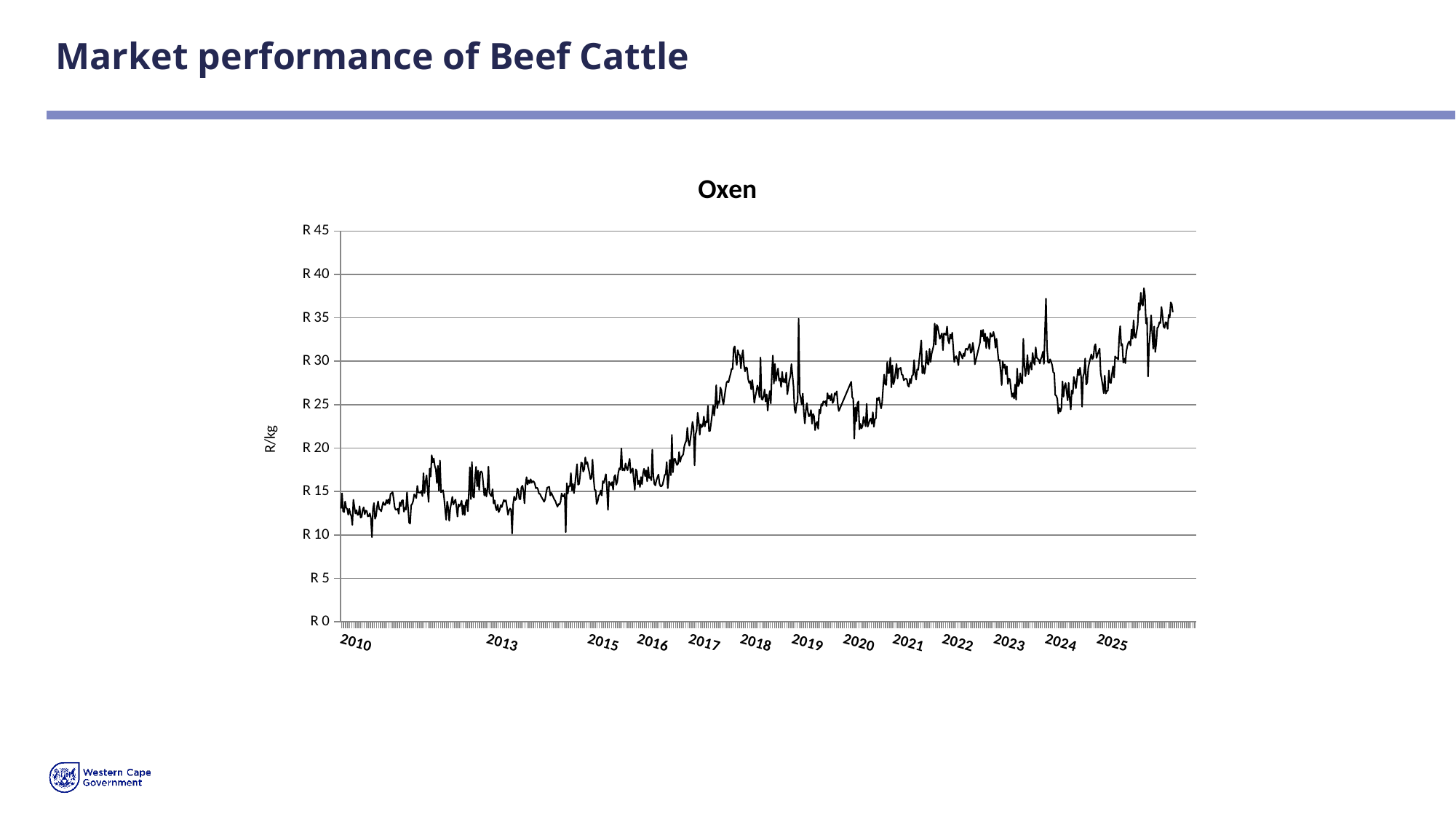
What is the label on the vertical axis of the chart? R/kg What kind of chart is shown on the slide? line chart Overall, does the Oxen price rise or fall from 2010 to 2025? rise Is the Oxen price around 2020 greater or less than R 35? less Which year has the higher Oxen price, 2010 or 2025? 2025 How many year labels are shown on the horizontal axis? 13 Is the Oxen price at the start of 2010 greater or less than R 20? less Is the Oxen price around 2022 greater or less than R 25? greater Which year has the higher Oxen price, 2013 or 2022? 2022 What is the title of the chart? Oxen